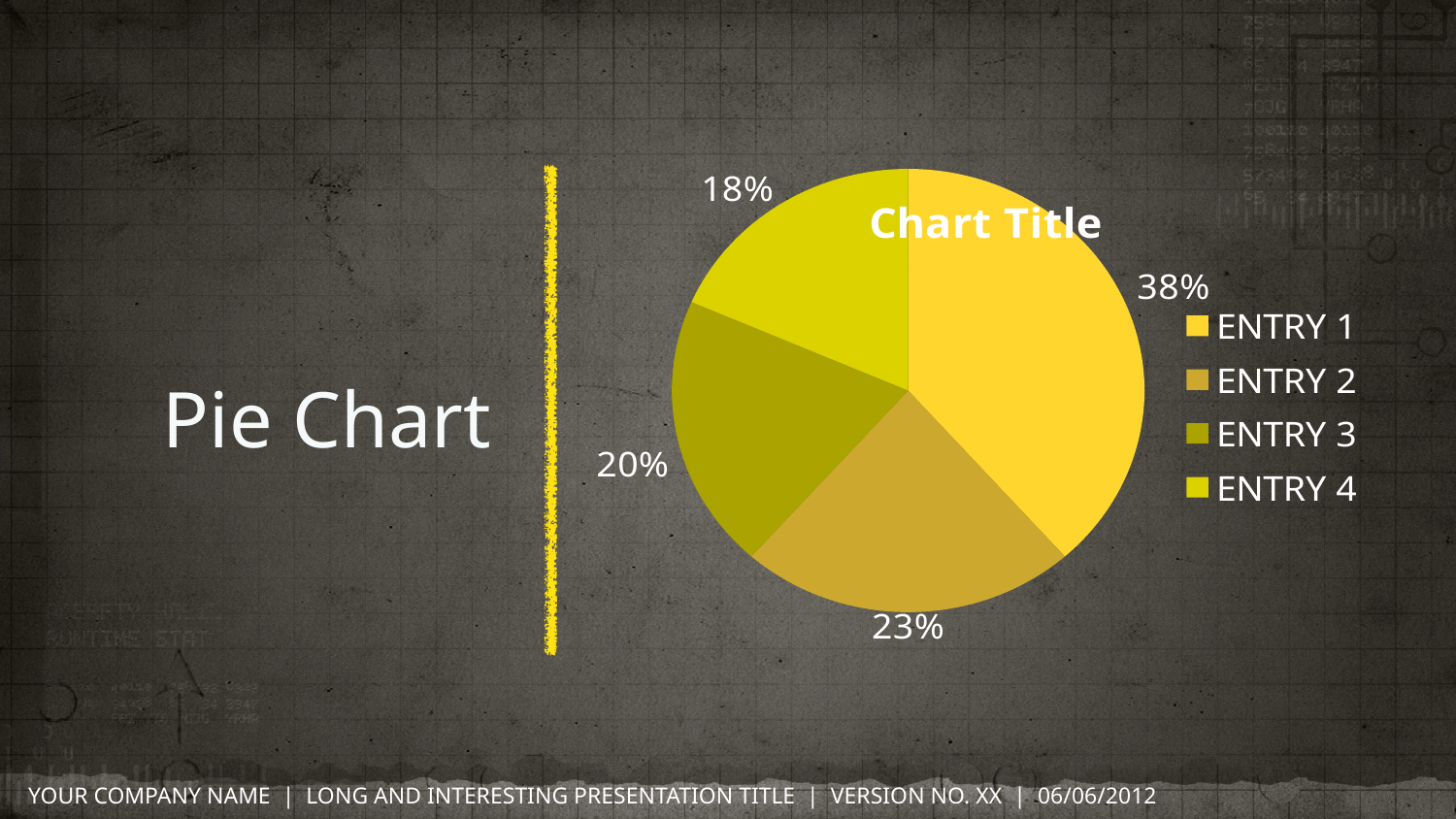
What kind of chart is shown on the slide? pie chart What is the difference in percentage points between ENTRY 1 and ENTRY 2? 15 How many entries does the legend list? 4 What share of the pie does ENTRY 1 have? 38% Which is larger, the share for ENTRY 3 or the share for ENTRY 4? ENTRY 3 Which entry has the smallest slice of the pie? ENTRY 4 What share of the pie does ENTRY 3 have? 20% Which entry has the largest slice of the pie? ENTRY 1 What share of the pie does ENTRY 4 have? 18% How many slices does the pie chart have? 4 What is the title of the chart? Chart Title